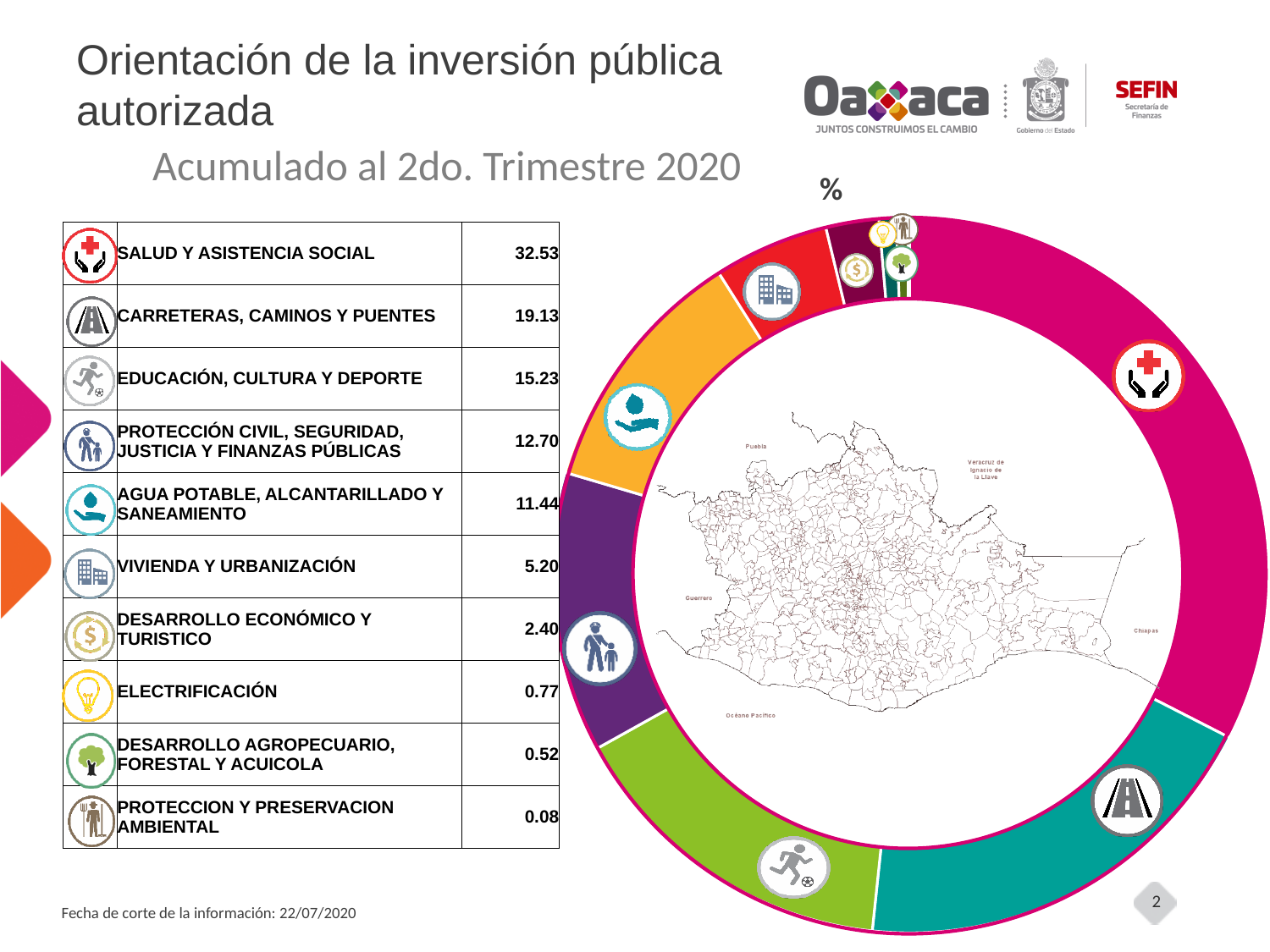
What is the difference between the values for DESARROLLO ECONÓMICO Y TURISTICO and ELECTRIFICACIÓN? 1.63 What is the value for SALUD Y ASISTENCIA SOCIAL? 32.53 What unit symbol is shown above the chart? % How many categories are shown in the chart? 10 Which category has the lowest value? PROTECCION Y PRESERVACION AMBIENTAL What is the value for ELECTRIFICACIÓN? 0.77 What is the difference between the values for SALUD Y ASISTENCIA SOCIAL and CARRETERAS, CAMINOS Y PUENTES? 13.40 What is the value for VIVIENDA Y URBANIZACIÓN? 5.20 Which category has the highest value? SALUD Y ASISTENCIA SOCIAL What kind of chart is shown on the slide? doughnut chart What is the value for CARRETERAS, CAMINOS Y PUENTES? 19.13 Which is larger, the value for EDUCACIÓN, CULTURA Y DEPORTE or the value for AGUA POTABLE, ALCANTARILLADO Y SANEAMIENTO? EDUCACIÓN, CULTURA Y DEPORTE